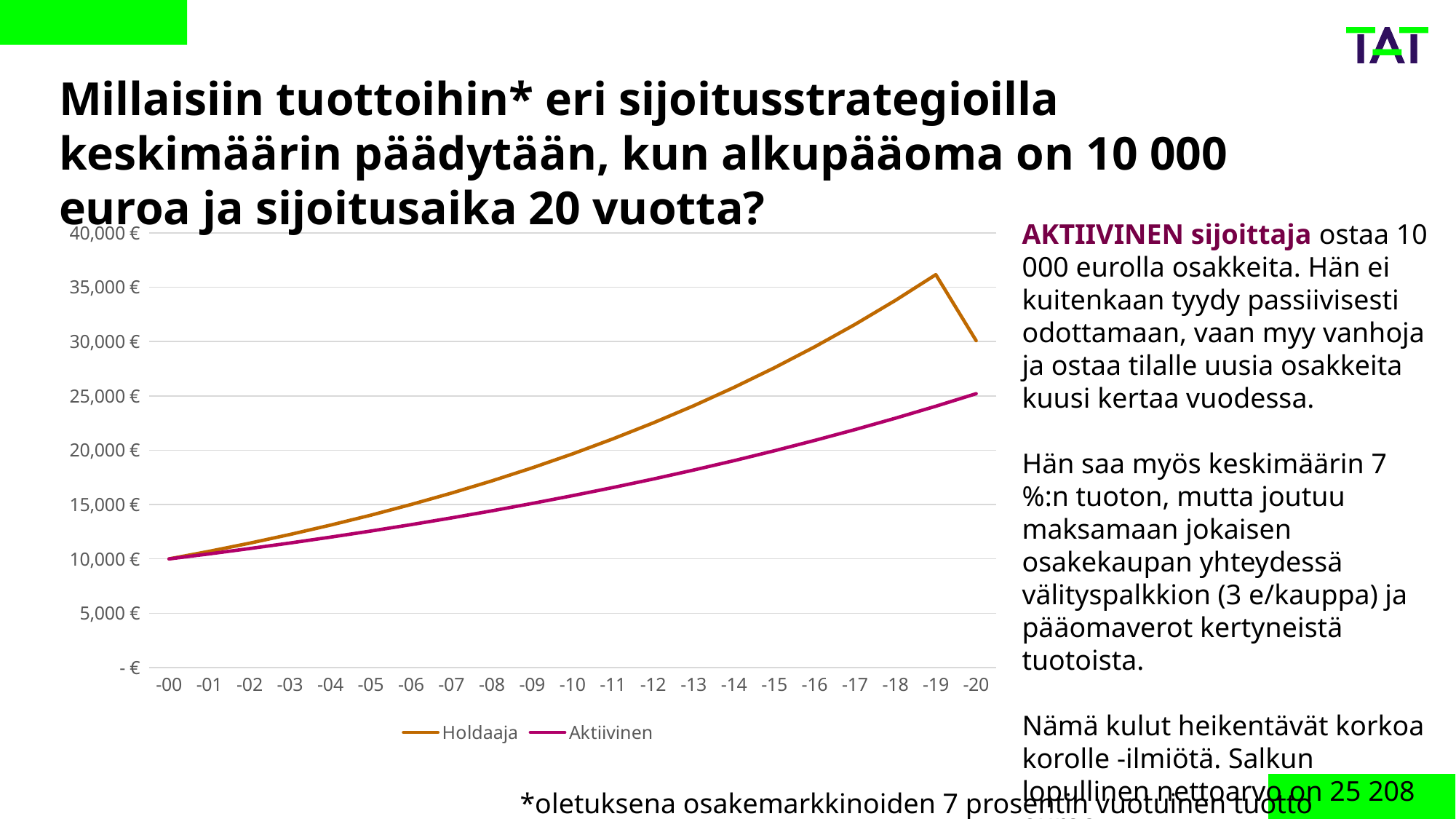
What are the two series named in the chart legend? Holdaaja and Aktiivinen Is the value for Holdaaja at -19 greater or less than 35,000 €? greater Which series reaches the highest value on the chart? Holdaaja How many points are plotted along the x axis for each series (from -00 to -20)? 21 Is the value for Aktiivinen at -10 greater or less than 15,000 €? greater What kind of chart is shown on the slide? line chart Is the value for Holdaaja at -05 greater or less than 15,000 €? less At -20, which series has the larger value, Holdaaja or Aktiivinen? Holdaaja What is the value of the Holdaaja series at -00? 10,000 € How many series does the chart legend list? 2 At which x-axis label does the Holdaaja series reach its peak? -19 Does the Aktiivinen series rise or fall along the x axis from -00 to -20? rise